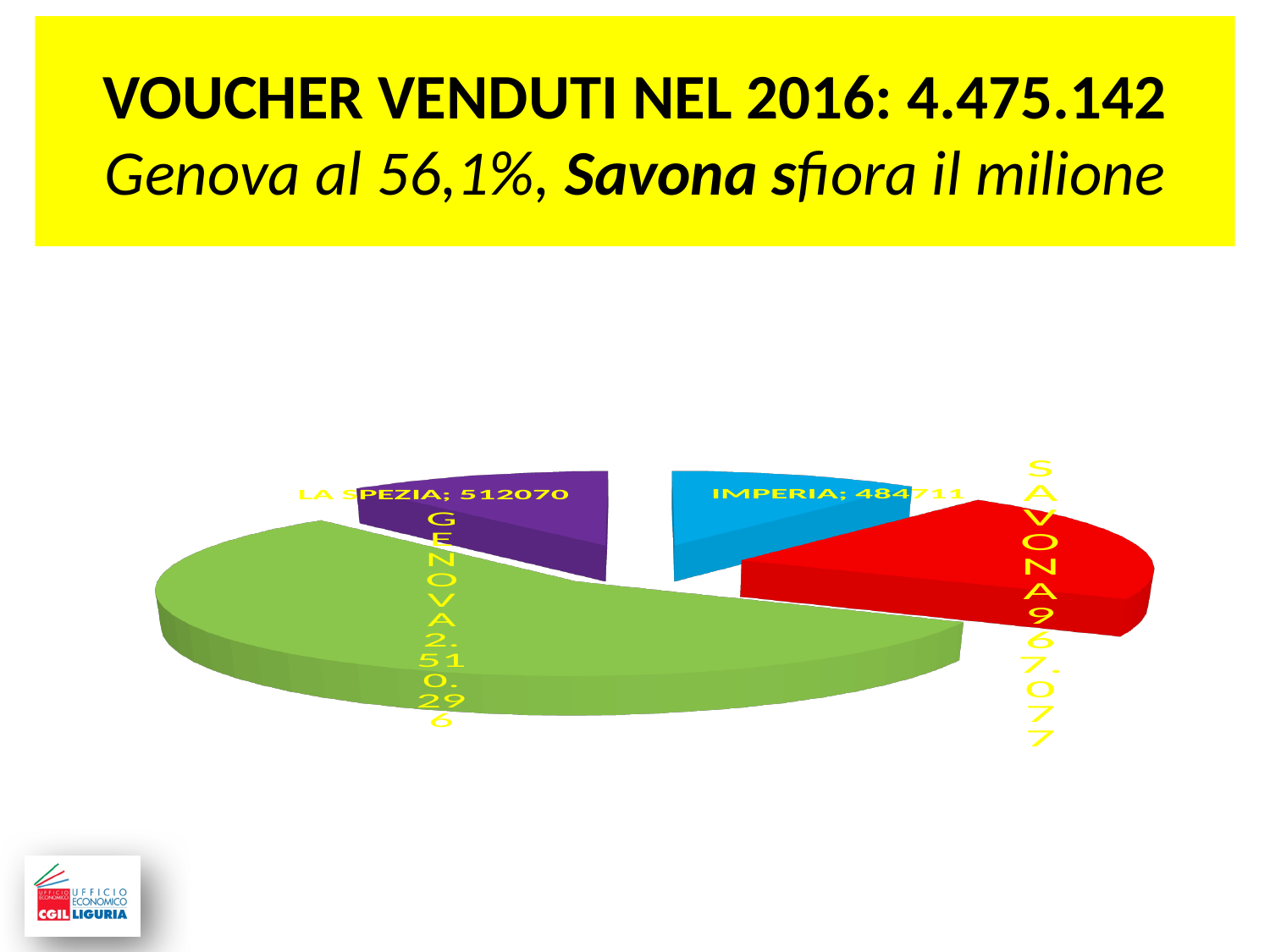
What is the value shown for SAVONA in the pie chart? 967.077 How many slices does the pie chart have? 4 Which province has the largest slice in the pie chart? GENOVA Which is larger, the value for SAVONA or the value for LA SPEZIA? SAVONA What type of chart is shown on the slide? Pie chart What is the value shown for LA SPEZIA in the pie chart? 512070 What is the value shown for IMPERIA in the pie chart? 484711 What total number of vouchers sold in 2016 is stated in the slide title? 4.475.142 Which province has the smallest slice in the pie chart? IMPERIA What is the value shown for GENOVA in the pie chart? 2.510.296 What is the difference between the values for LA SPEZIA and IMPERIA? 27359 According to the slide, what share of the vouchers sold in 2016 does Genova account for? 56,1%